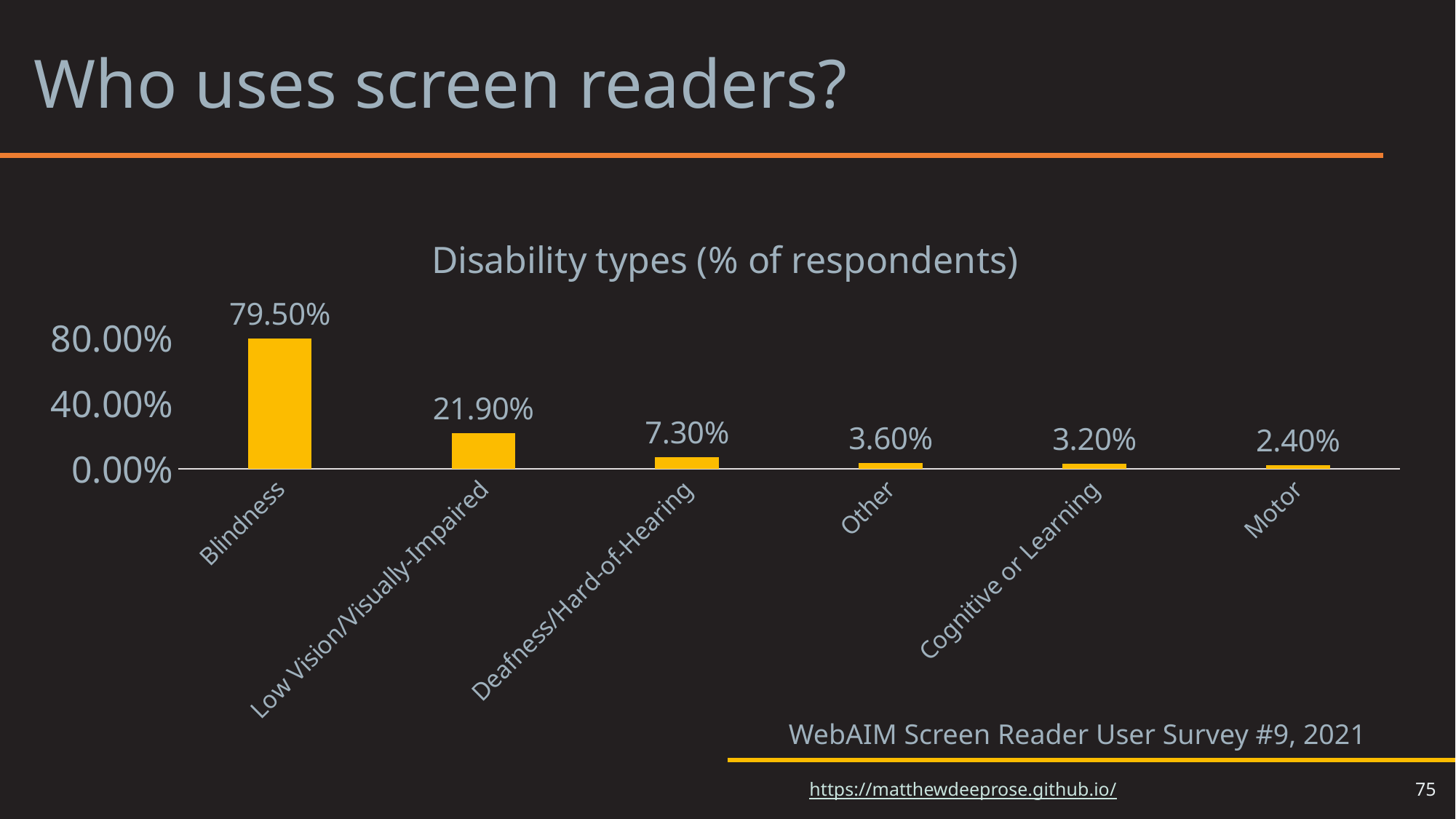
What is the value for Cognitive or Learning? 3.20% What is the difference between the values for Blindness and Low Vision/Visually-Impaired? 57.60% Which is larger, the value for Other or the value for Motor? Other What is the title of the chart? Disability types (% of respondents) Which disability type has the lowest percentage of respondents? Motor What is the value for Blindness? 79.50% How many disability types are shown in the chart? 6 What kind of chart is shown on the slide? bar chart Is the value for Low Vision/Visually-Impaired greater or less than 40.00%? less Which disability type has the highest percentage of respondents? Blindness What is the value for Low Vision/Visually-Impaired? 21.90% What is the value for Deafness/Hard-of-Hearing? 7.30%